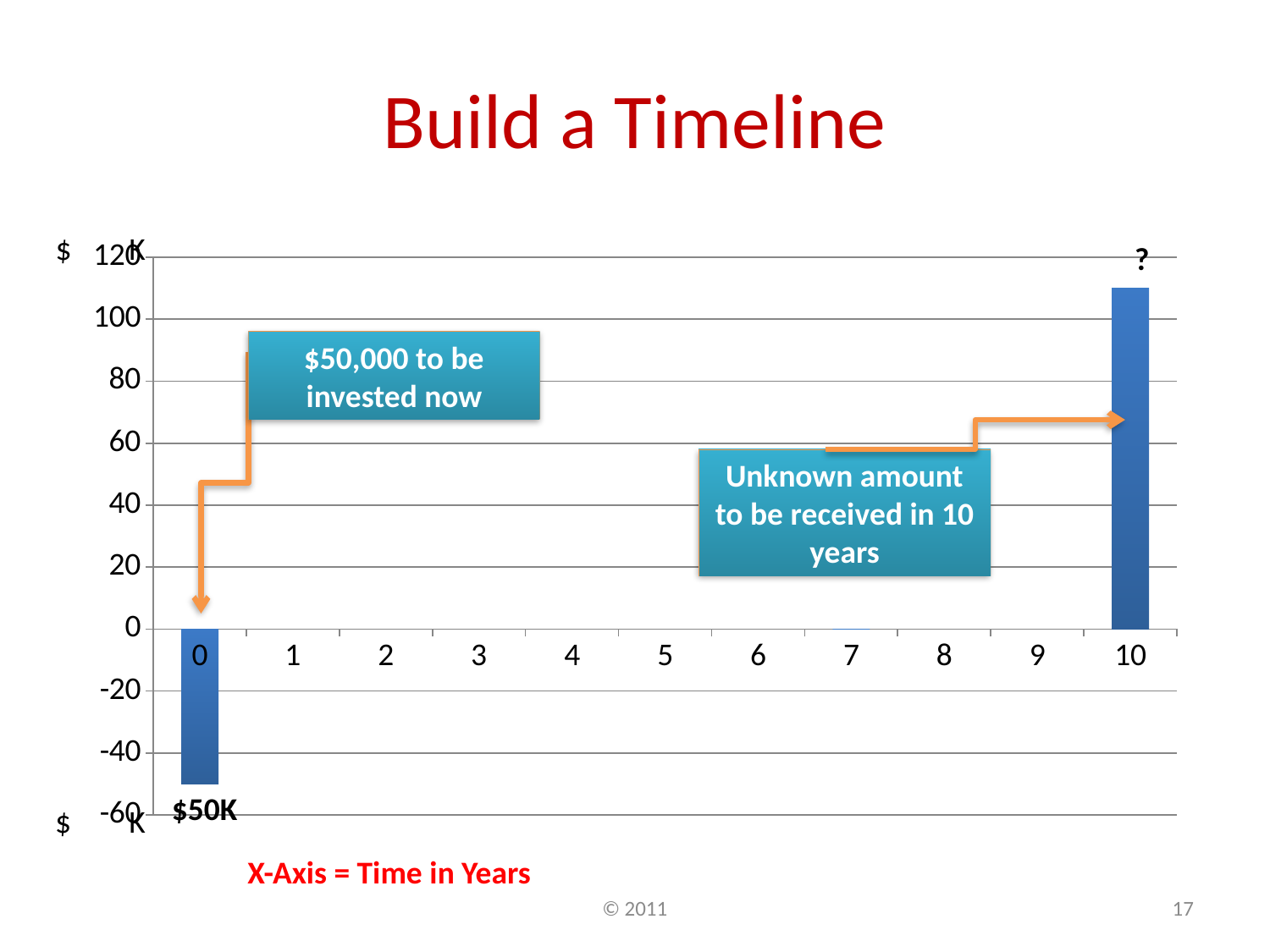
What kind of chart is shown on the slide? bar chart Which year has the higher bar value, year 0 or year 10? year 10 What does the x-axis represent according to the caption below the chart? Time in Years How many bars are plotted on the chart? 2 What label is printed above the bar at year 10? ? What is the highest value shown on the y-axis? 120 Is the value of the bar at year 10 greater or less than 100? greater What is the title of the slide containing the chart? Build a Timeline What is the last year shown on the x-axis? 10 Is the value of the bar at year 0 greater or less than -40? less What label is printed beneath the bar at year 0? $50K Which year has the lowest bar value on the chart? 0